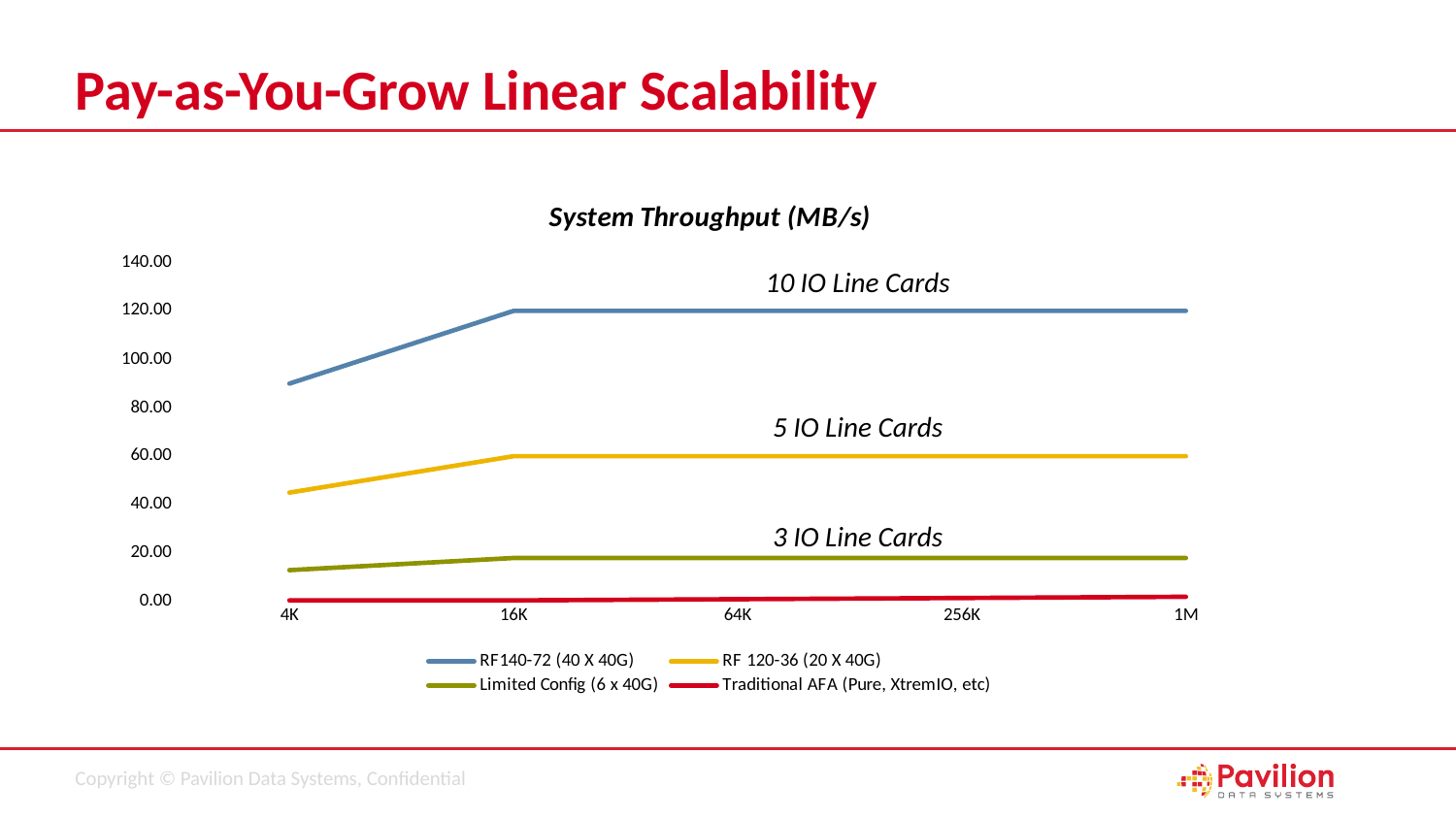
Which series has the highest value at 1M? RF140-72 (40 X 40G) At 64K, which is larger: RF 120-36 (20 X 40G) or Limited Config (6 x 40G)? RF 120-36 (20 X 40G) What is the title of the chart? System Throughput (MB/s) Is the value for RF140-72 (40 X 40G) at 4K greater or less than 80? greater How many categories are shown on the x axis? 5 Is the value for RF140-72 (40 X 40G) at 4K greater or less than 100? less Does the value for RF140-72 (40 X 40G) rise or fall from 4K to 16K? rise Is the value for Limited Config (6 x 40G) at 1M greater or less than 20? less What kind of chart is shown on the slide? line chart How many series does the legend list? 4 Which series has the lowest value at 64K? Traditional AFA (Pure, XtremIO, etc)